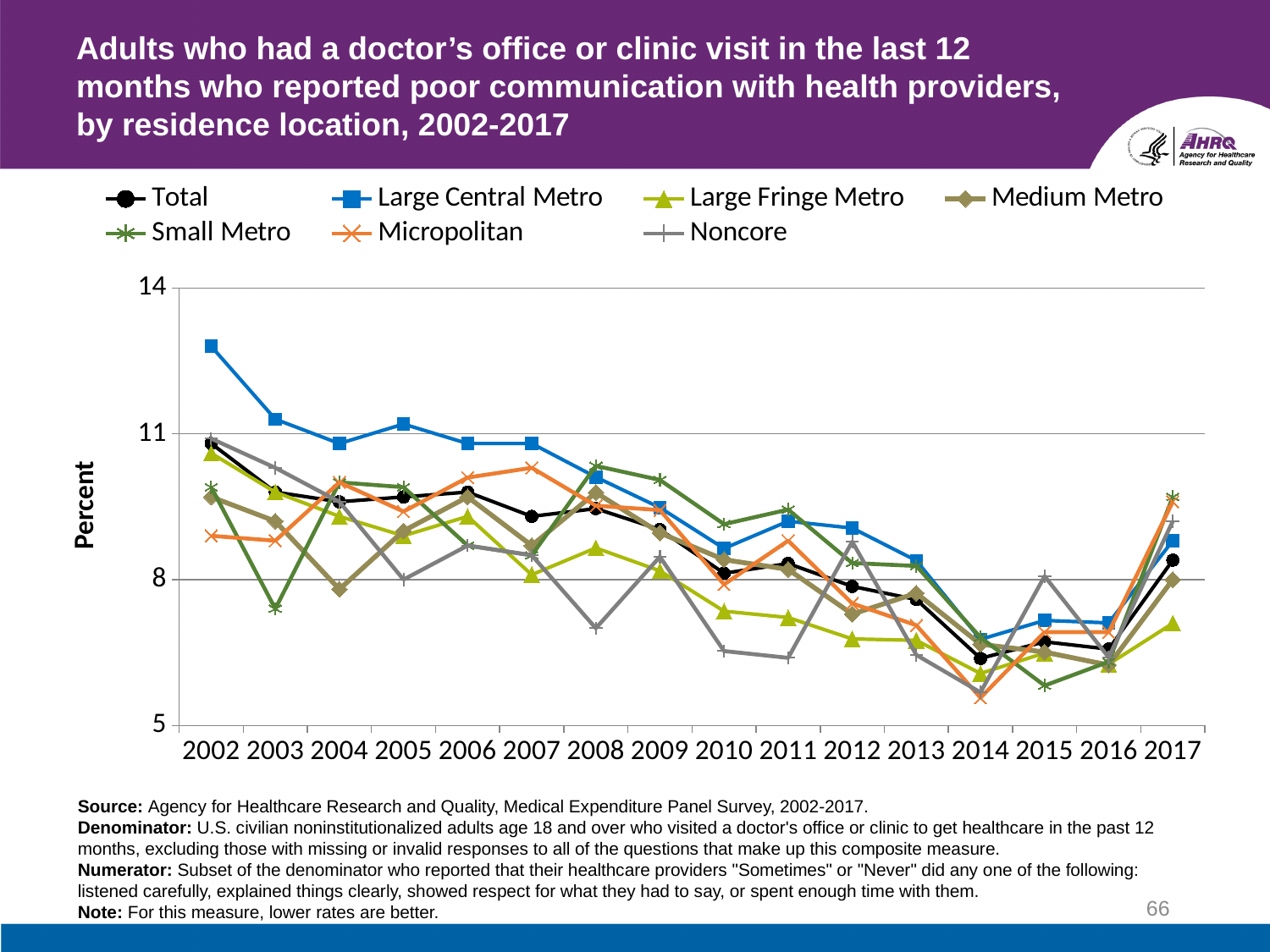
Is the value for Noncore in 2014 greater or less than 8? less How many series does the legend list? 7 Is the value for Large Central Metro in 2002 greater or less than 11? greater Which series has the highest value in 2002? Large Central Metro In which year does the Large Central Metro series reach its highest value? 2002 What is the label on the y axis? Percent Does the Total series generally rise or fall from 2002 to 2014? fall Which is larger in 2008, Large Central Metro or Noncore? Large Central Metro Is the value for Total in 2014 greater or less than 8? less How many years are plotted along the x axis? 16 What kind of chart is shown on the slide? Line chart